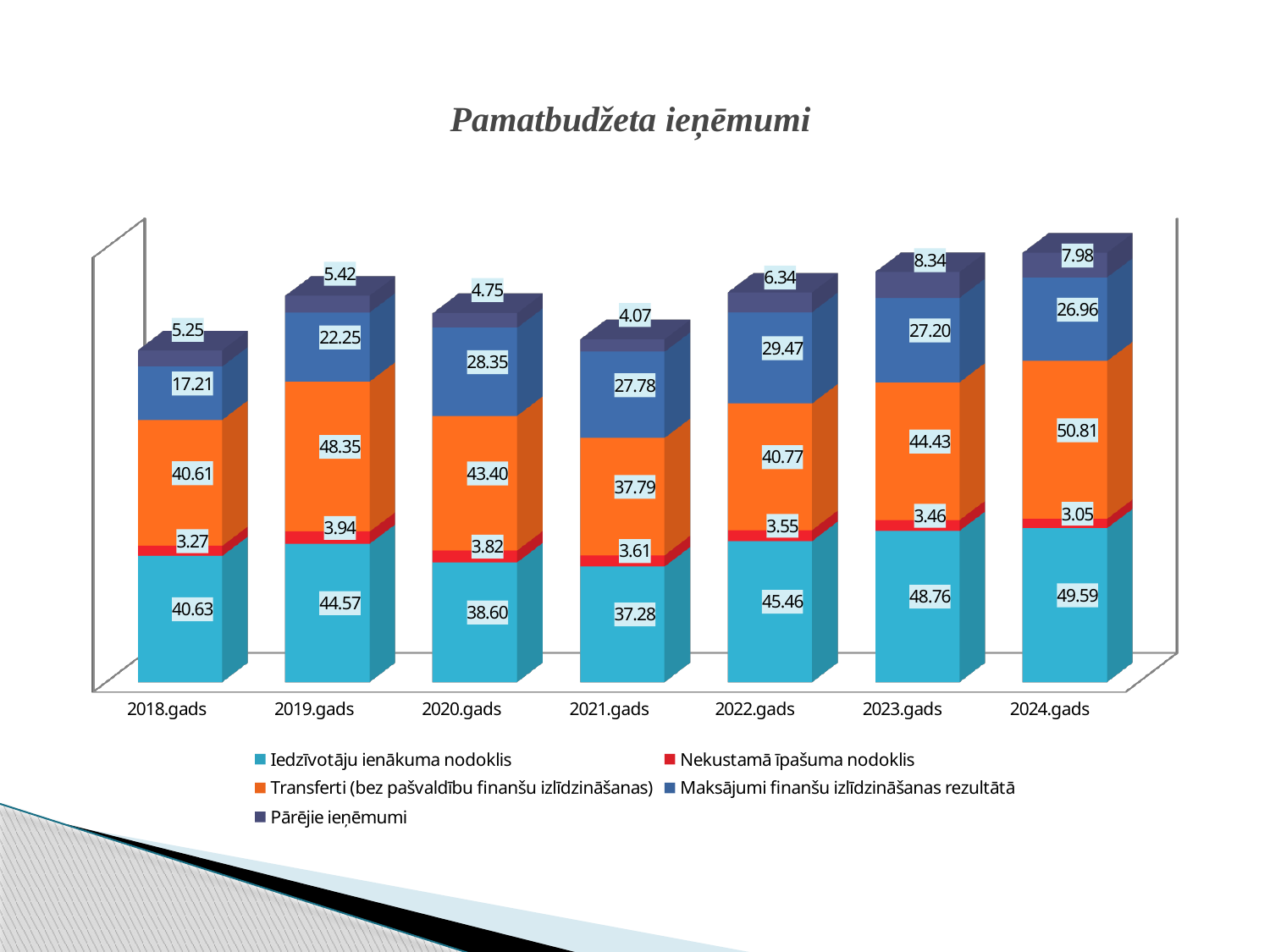
In which year is Iedzīvotāju ienākuma nodoklis the lowest? 2021.gads How many years are shown on the x axis? 7 What is the difference between Iedzīvotāju ienākuma nodoklis in 2024.gads and in 2018.gads? 8.96 What is the value of Maksājumi finanšu izlīdzināšanas rezultātā for 2022.gads? 29.47 How many series does the legend list? 5 What is the total of the stacked bar for 2024.gads? 138.39 In which year is Pārējie ieņēmumi the highest? 2023.gads What is the value of Transferti (bez pašvaldību finanšu izlīdzināšanas) for 2019.gads? 48.35 What kind of chart is shown on the slide? Stacked bar chart Which is larger: Transferti (bez pašvaldību finanšu izlīdzināšanas) in 2020.gads or in 2021.gads? 2020.gads What is the value of Iedzīvotāju ienākuma nodoklis for 2018.gads? 40.63 What is the title of the chart? Pamatbudžeta ieņēmumi